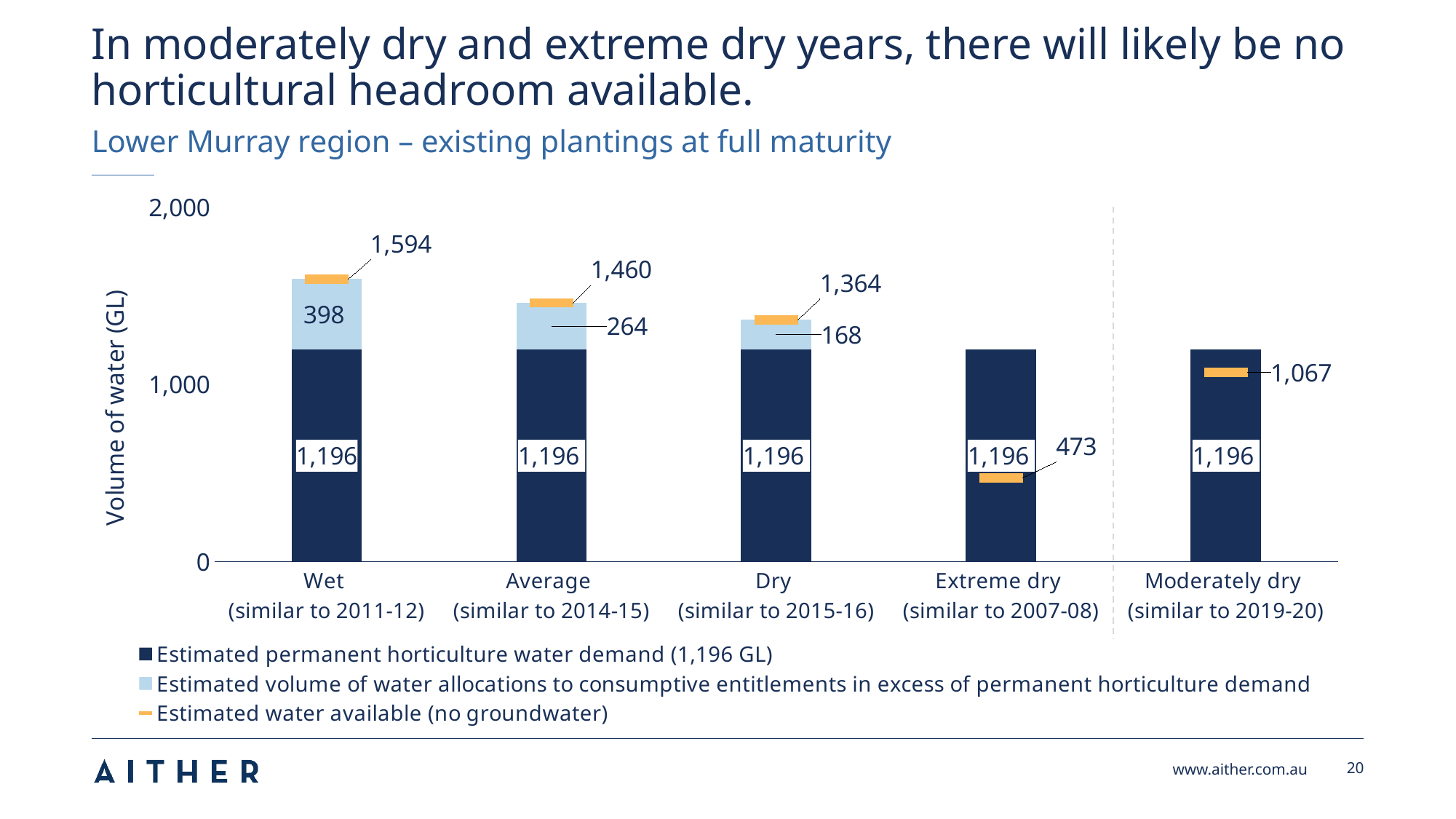
What kind of chart is shown on the slide? Stacked bar chart What is the estimated permanent horticulture water demand shown for the Dry scenario? 1,196 What is the total height of the stacked bar for the Wet scenario (demand plus excess allocations)? 1,594 How many series does the legend list? 3 Which scenario has the lowest estimated water available (no groundwater)? Extreme dry What is the estimated volume of water allocations in excess of permanent horticulture demand for the Average scenario? 264 How many scenarios are shown on the x axis? 5 Which has a larger estimated water available value: the Dry scenario or the Moderately dry scenario? Dry What is the estimated water available (no groundwater) for the Wet scenario? 1,594 Is the estimated water available for the Extreme dry scenario greater or less than 1,000? less What is the difference between the estimated water available for the Wet scenario and the Average scenario? 134 Which scenario has the highest estimated water available (no groundwater)? Wet